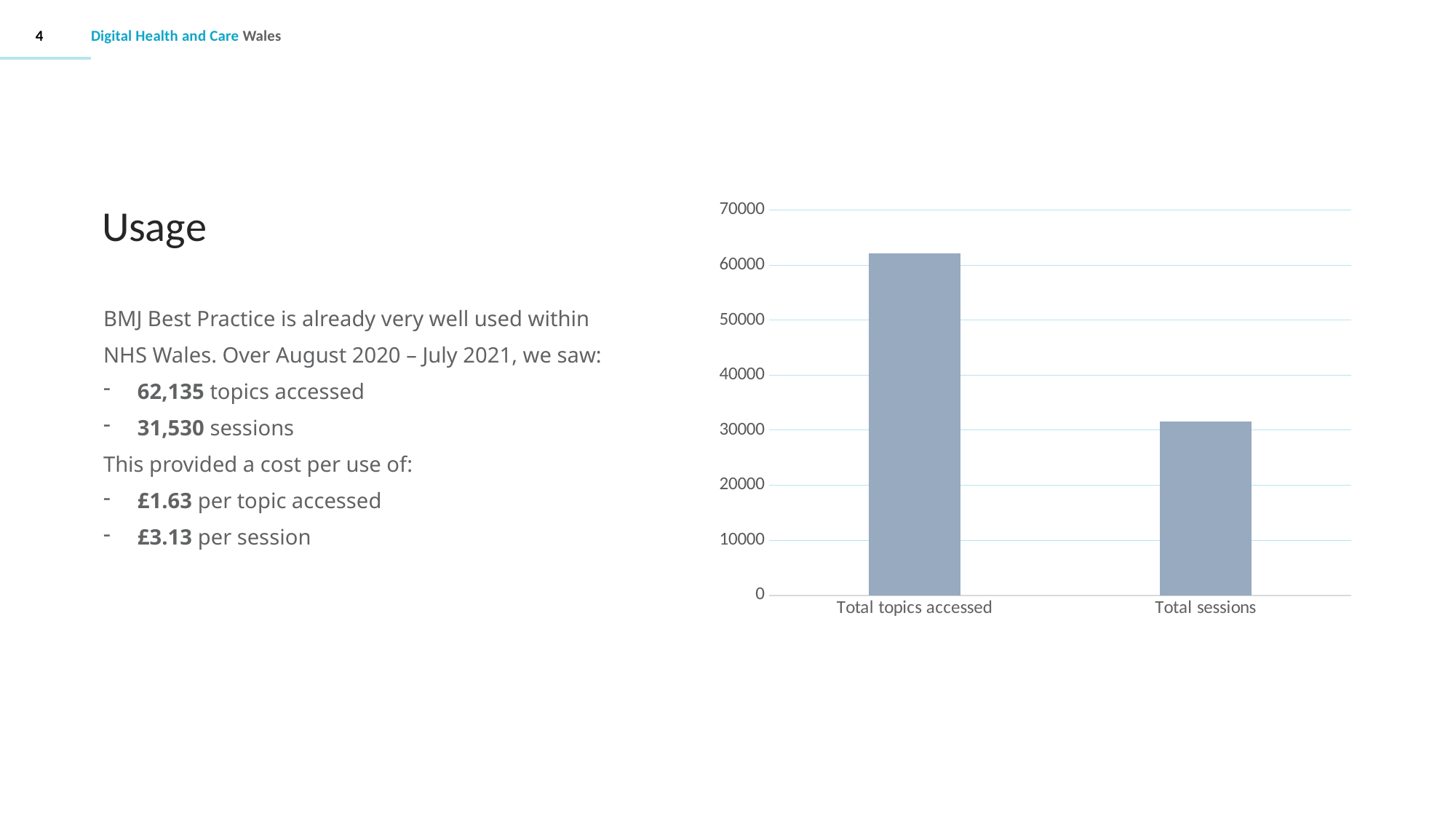
How many categories are plotted in the chart? 2 Which category has the highest bar in the chart? Total topics accessed Do the bar values rise or fall from left to right across the chart? fall Is the value for Total sessions greater or less than 30000? greater What is the highest value shown on the chart's vertical axis? 70000 Which category has the lowest bar in the chart? Total sessions Which is larger in the chart, Total topics accessed or Total sessions? Total topics accessed Is the value for Total topics accessed greater or less than 60000? greater What is the label of the rightmost bar in the chart? Total sessions Is the value for Total sessions greater or less than 40000? less What kind of chart is shown on the slide? bar chart